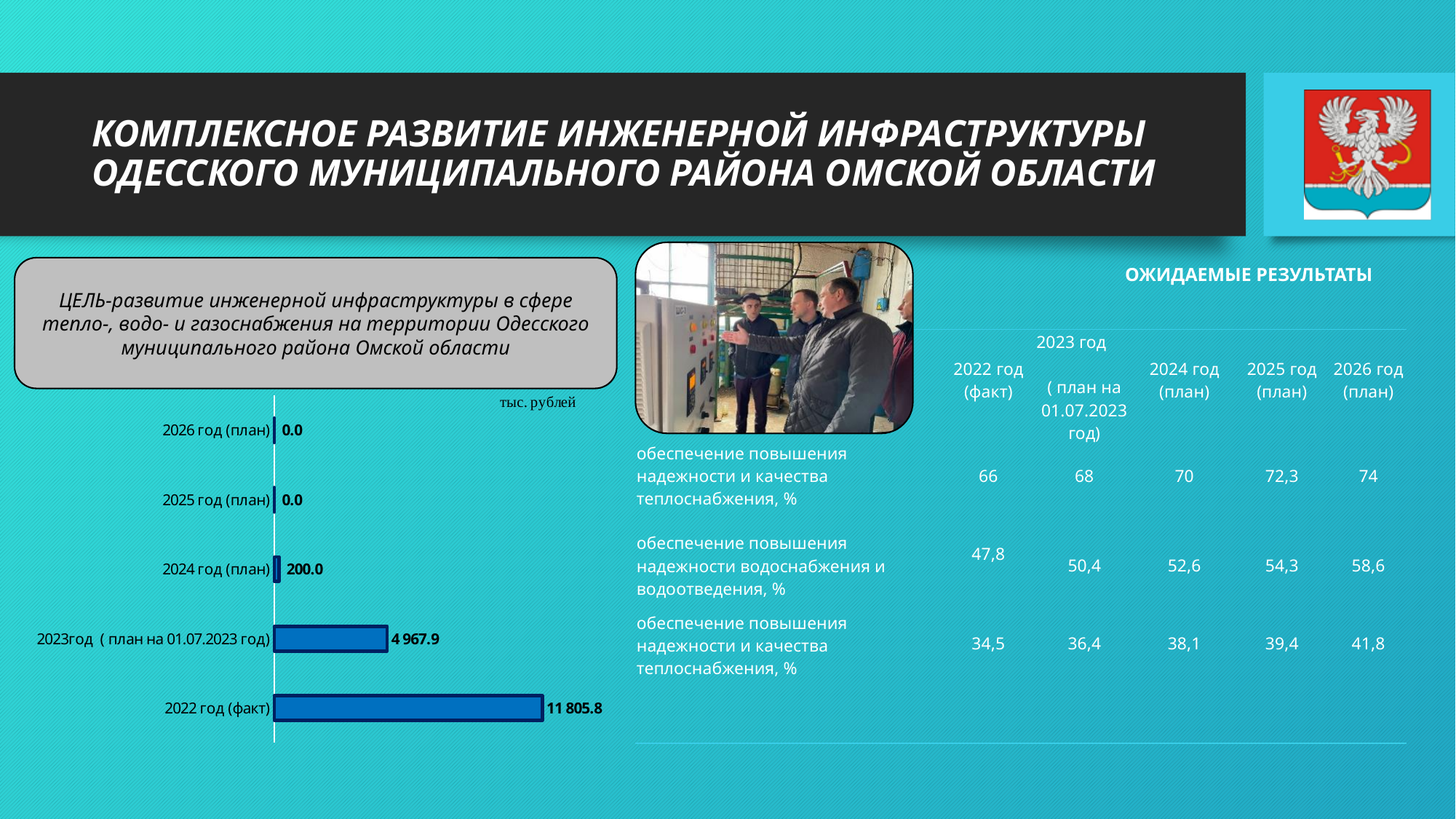
How many categories are shown in the bar chart? 5 What is the difference between the values for 2023год (план на 01.07.2023 год) and 2024 год (план) in the bar chart? 4 767.9 Which category has the highest value in the bar chart? 2022 год (факт) What type of chart is shown on the left of the slide? Bar chart What is the value for 2022 год (факт) in the bar chart? 11 805.8 What is the difference between the values for 2022 год (факт) and 2023год (план на 01.07.2023 год) in the bar chart? 6 837.9 What is the value for 2024 год (план) in the bar chart? 200.0 What unit is indicated for the values in the bar chart? тыс. рублей What is the value for 2023год (план на 01.07.2023 год) in the bar chart? 4 967.9 What is the value for 2026 год (план) in the bar chart? 0.0 Which is larger in the bar chart: the value for 2024 год (план) or the value for 2025 год (план)? 2024 год (план) How many categories in the bar chart have a value of 0.0? 2